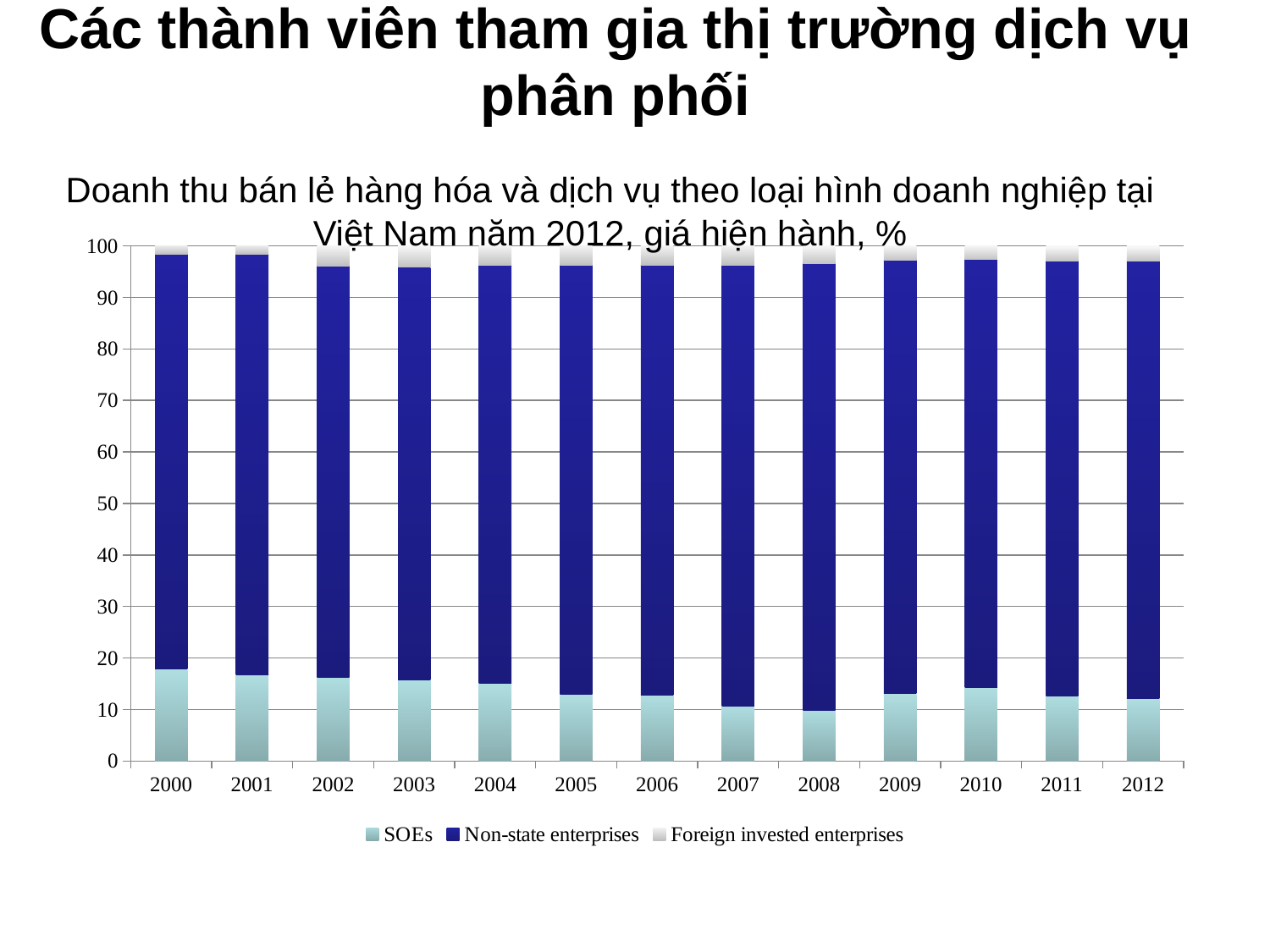
In which year is the SOEs share the highest? 2000 Which series is shown in dark blue in the chart? Non-state enterprises Which series is listed first in the chart's legend? SOEs Is the SOEs value for 2000 greater or less than 10? greater How many series does the chart's legend list? 3 What kind of chart is shown on the slide? Stacked bar chart In which year is the SOEs share the lowest? 2008 Is the SOEs value for 2000 greater or less than 20? less Which year has a larger SOEs share, 2000 or 2008? 2000 Does the SOEs share rise or fall from 2000 to 2008? Fall How many years are shown on the x axis of the chart? 13